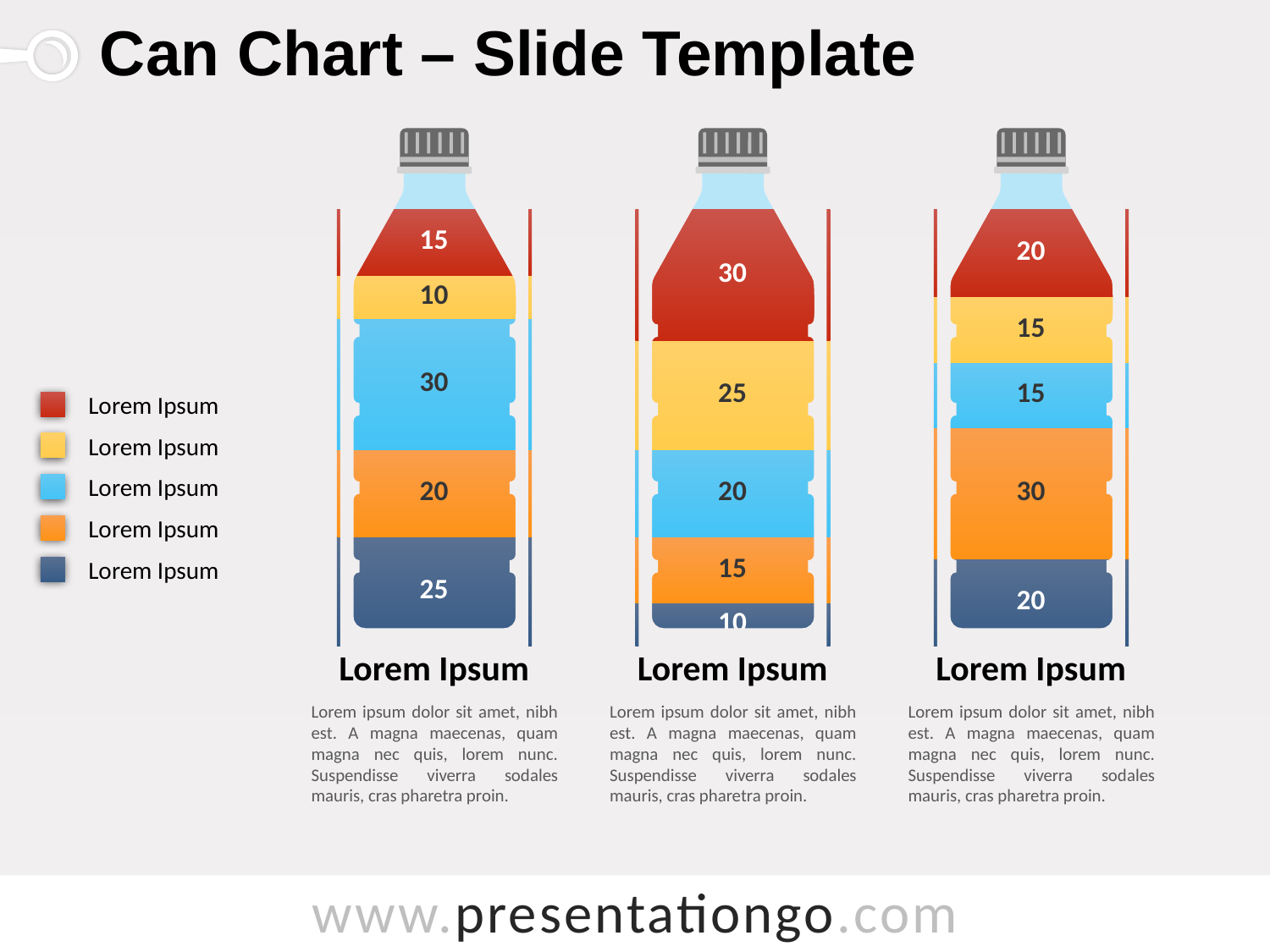
In the left bottle, what value is shown in the dark blue segment at the bottom? 25 What is the total of all segments in the middle bottle? 100 In the middle bottle, what value is shown in the yellow segment? 25 What kind of chart is shown on the slide? Stacked bar chart (bottle-shaped) In the middle bottle, which coloured segment has the largest value? Red How many entries does the legend list? 5 In the left bottle, what is the difference between the light blue segment and the yellow segment? 20 In the right bottle, what value is shown in the orange segment? 30 In the middle bottle, which coloured segment has the smallest value? Dark blue How many segments does each bottle contain? 5 In the right bottle, which is larger: the red segment or the orange segment? Orange In the left bottle, what value is shown in the red segment at the top? 15